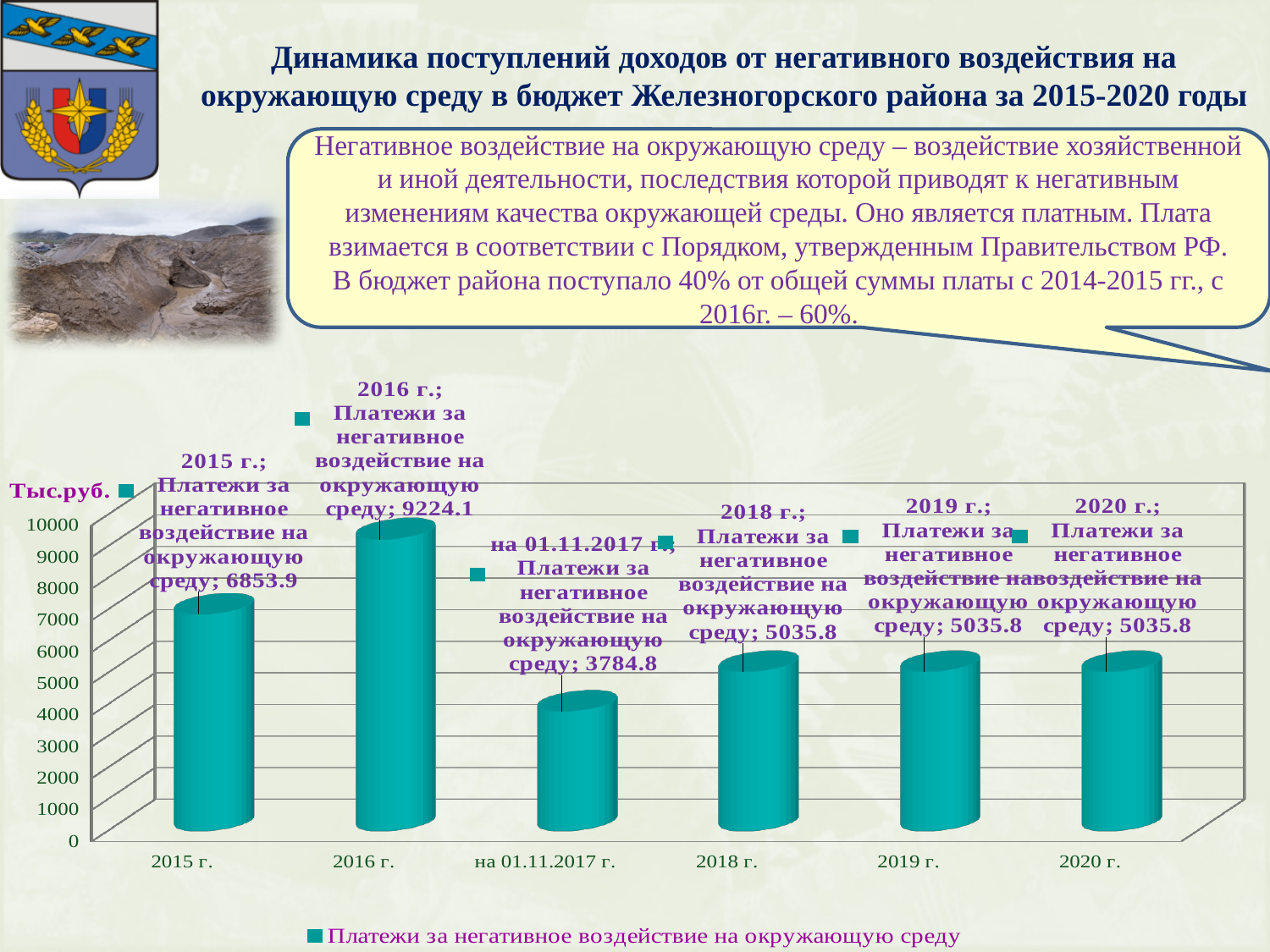
What is the difference between the values for 2016 г. and 2015 г.? 2370.2 Which category has the lowest value of payments? на 01.11.2017 г. Which year has the highest value of payments? 2016 г. What is the value shown for 2018 г.? 5035.8 How many categories (time periods) are shown on the x axis? 6 What kind of chart is shown on the slide? bar chart Which is larger, the value for 2015 г. or the value for 2018 г.? 2015 г. How many series does the legend list? 1 What is the value of payments for negative environmental impact for 2015 г.? 6853.9 What is the value shown for 2016 г.? 9224.1 Is the value for на 01.11.2017 г. greater or less than 4000? less What is the value shown for на 01.11.2017 г.? 3784.8